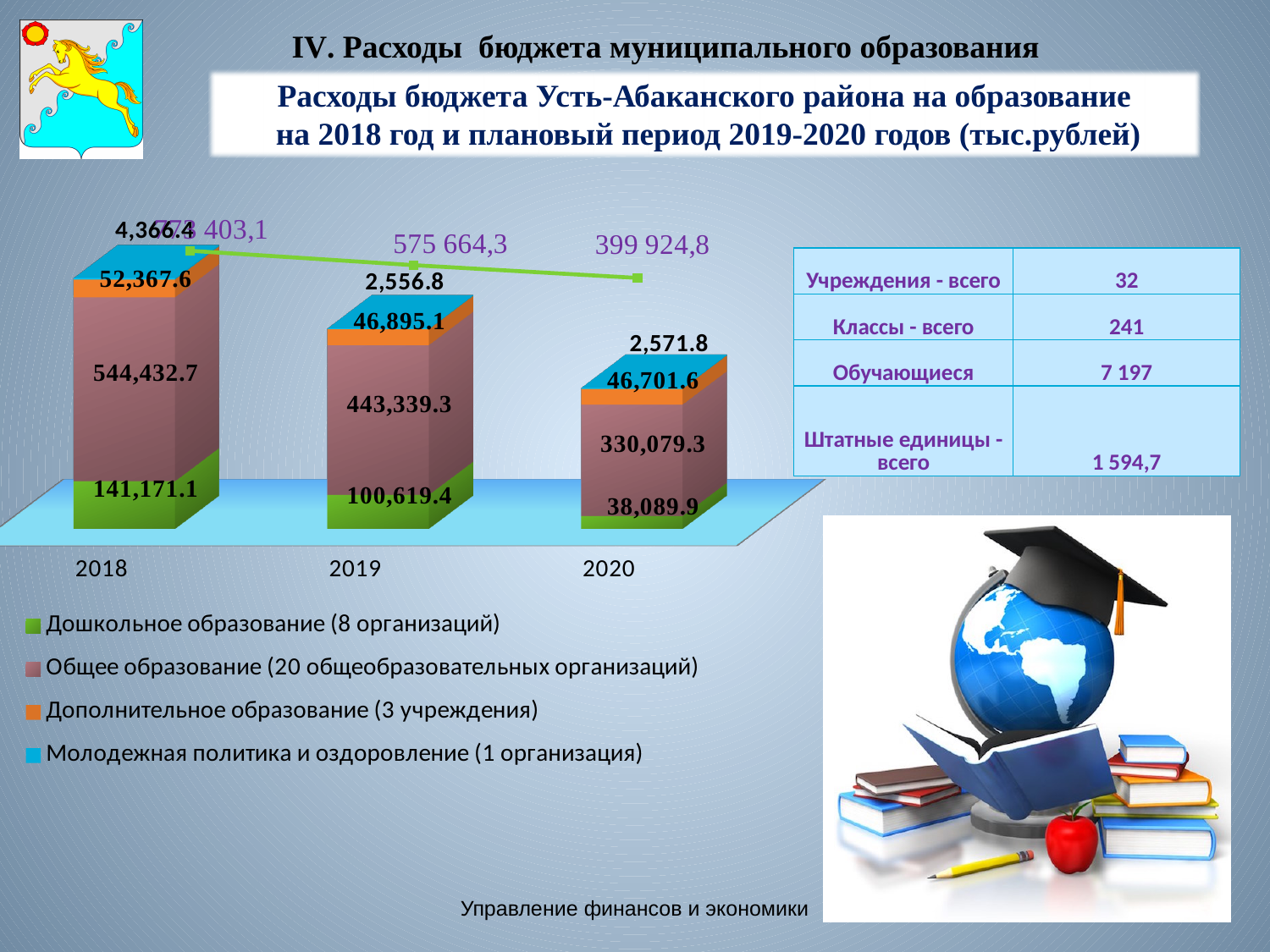
What kind of chart is shown on the slide? stacked bar chart Does the value for Общее образование rise or fall from 2018 to 2020? fall What is the difference between the Общее образование values for 2018 and 2019? 101,093.4 What is the value for Общее образование in 2018? 544,432.7 How many years are shown on the x axis of the chart? 3 What is the value for Дополнительное образование in 2019? 46,895.1 What is the value for Дошкольное образование in 2020? 38,089.9 How many series does the chart legend list? 4 Which is larger: Дополнительное образование in 2019 or in 2020? 2019 What is the value for Молодежная политика и оздоровление in 2018? 4,366.4 In which year is the value for Общее образование the highest? 2018 In which year is the value for Дошкольное образование the lowest? 2020